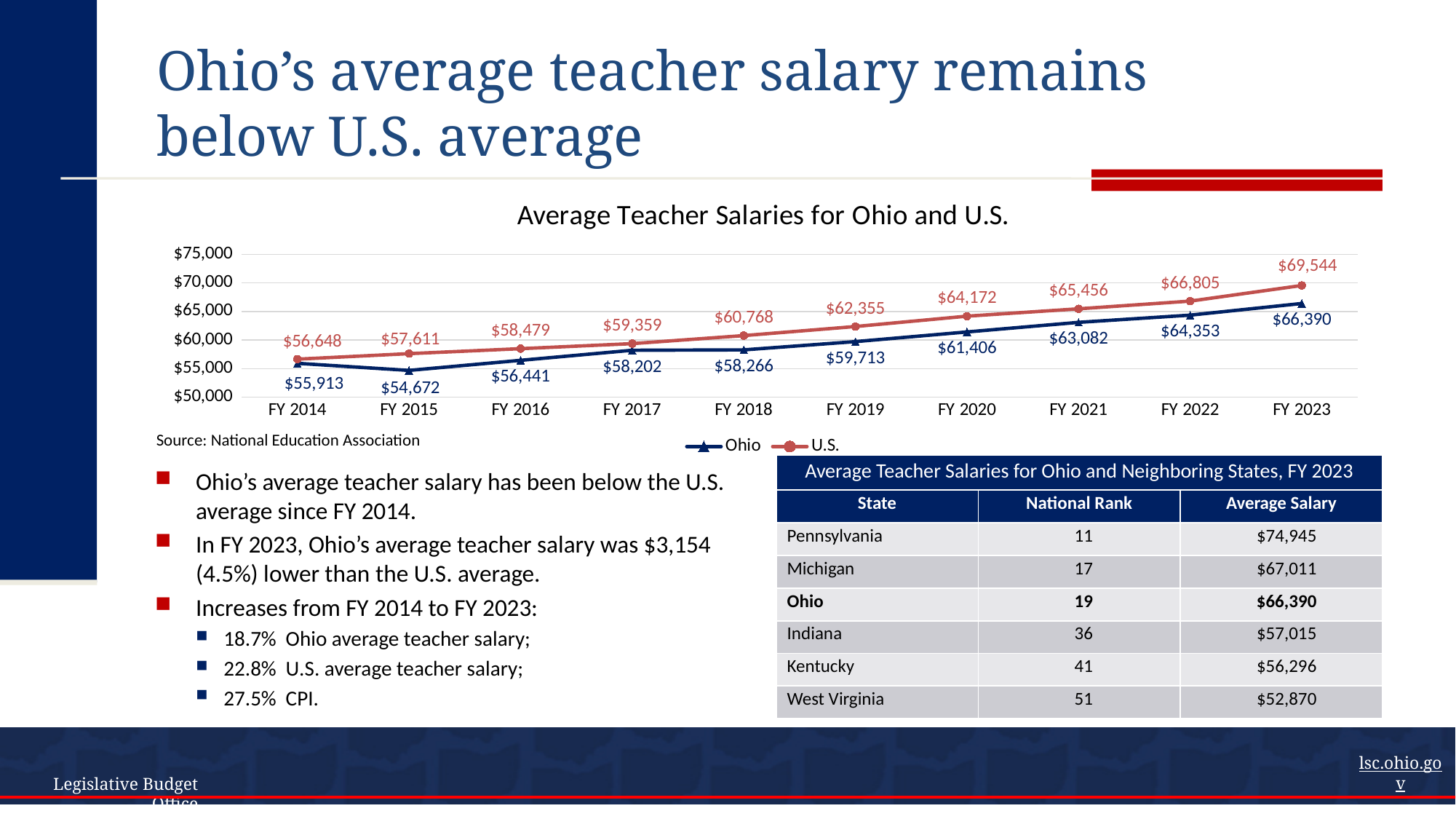
In which fiscal year is the U.S. average teacher salary the highest? FY 2023 What is the U.S. average teacher salary for FY 2023? $69,544 What kind of chart is used to show the average teacher salaries? line chart In which fiscal year is the Ohio average teacher salary the lowest? FY 2015 What is the difference between the U.S. and Ohio average teacher salaries in FY 2023? $3,154 In FY 2018, which is larger, the Ohio or the U.S. average teacher salary? U.S. How many fiscal years are shown on the x axis of the chart? 10 How many series does the chart's legend list? 2 What is the Ohio average teacher salary for FY 2014? $55,913 What is the difference between the U.S. and Ohio average teacher salaries in FY 2014? $735 Is the Ohio average teacher salary for FY 2020 greater or less than $60,000? greater Does the U.S. average teacher salary rise or fall from FY 2014 to FY 2023? rise